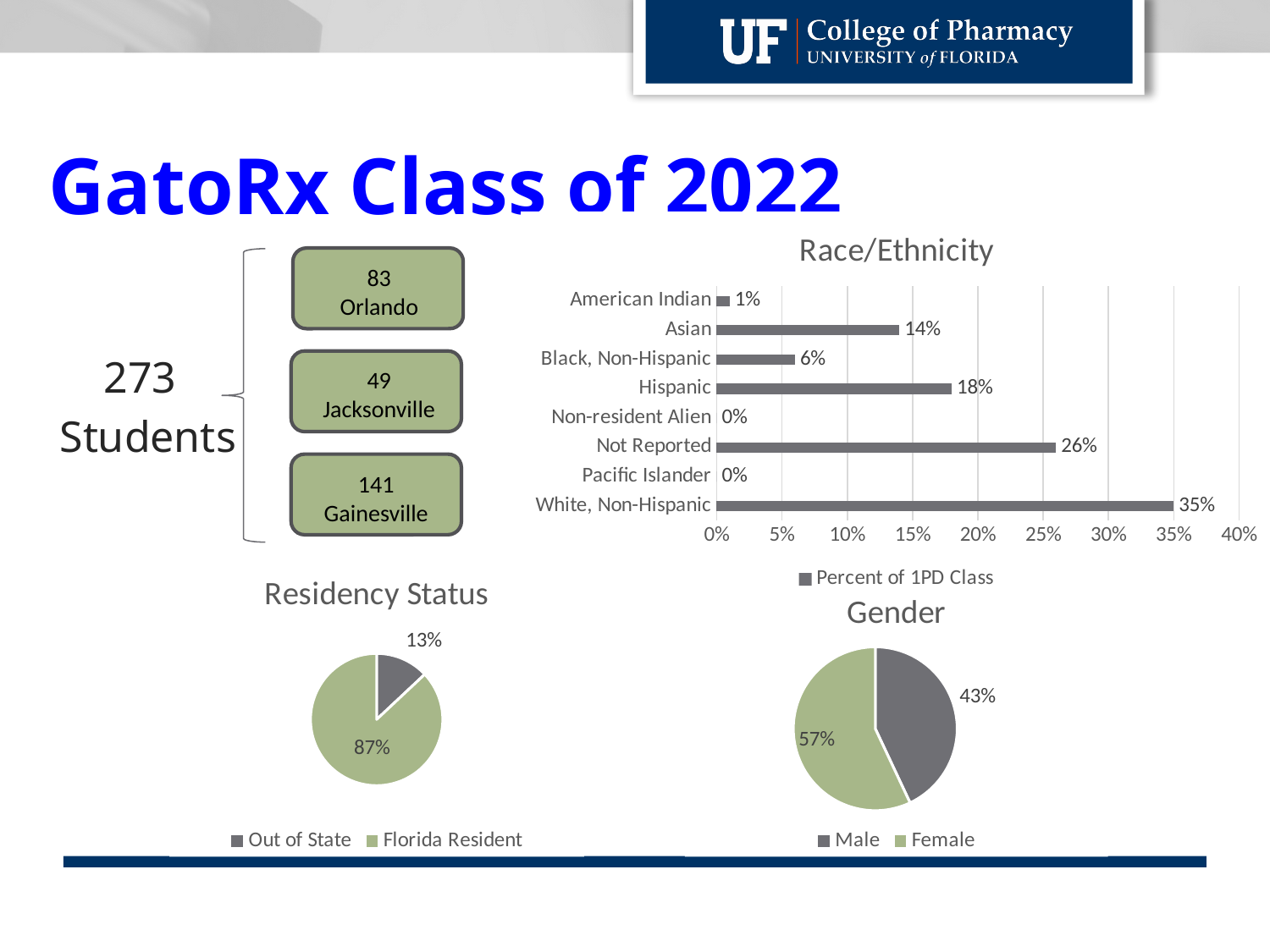
What kind of chart is the Race/Ethnicity chart? Bar chart In the Residency Status pie chart, what share is Florida Resident? 87% In the Race/Ethnicity chart, what is the value for Asian? 14% In the Gender pie chart, which is larger, Male or Female? Female How many categories are shown in the Race/Ethnicity chart? 8 In the Race/Ethnicity chart, which category has the highest value? White, Non-Hispanic In the Race/Ethnicity chart, what is the value for Hispanic? 18% In the Race/Ethnicity chart, what is the difference between White, Non-Hispanic and Not Reported? 9% In the Residency Status pie chart, what is the value for Out of State? 13% In the Race/Ethnicity chart, which is larger, Asian or Black, Non-Hispanic? Asian In the Gender pie chart, what share is Male? 43% What series name does the legend of the Race/Ethnicity chart show? Percent of 1PD Class